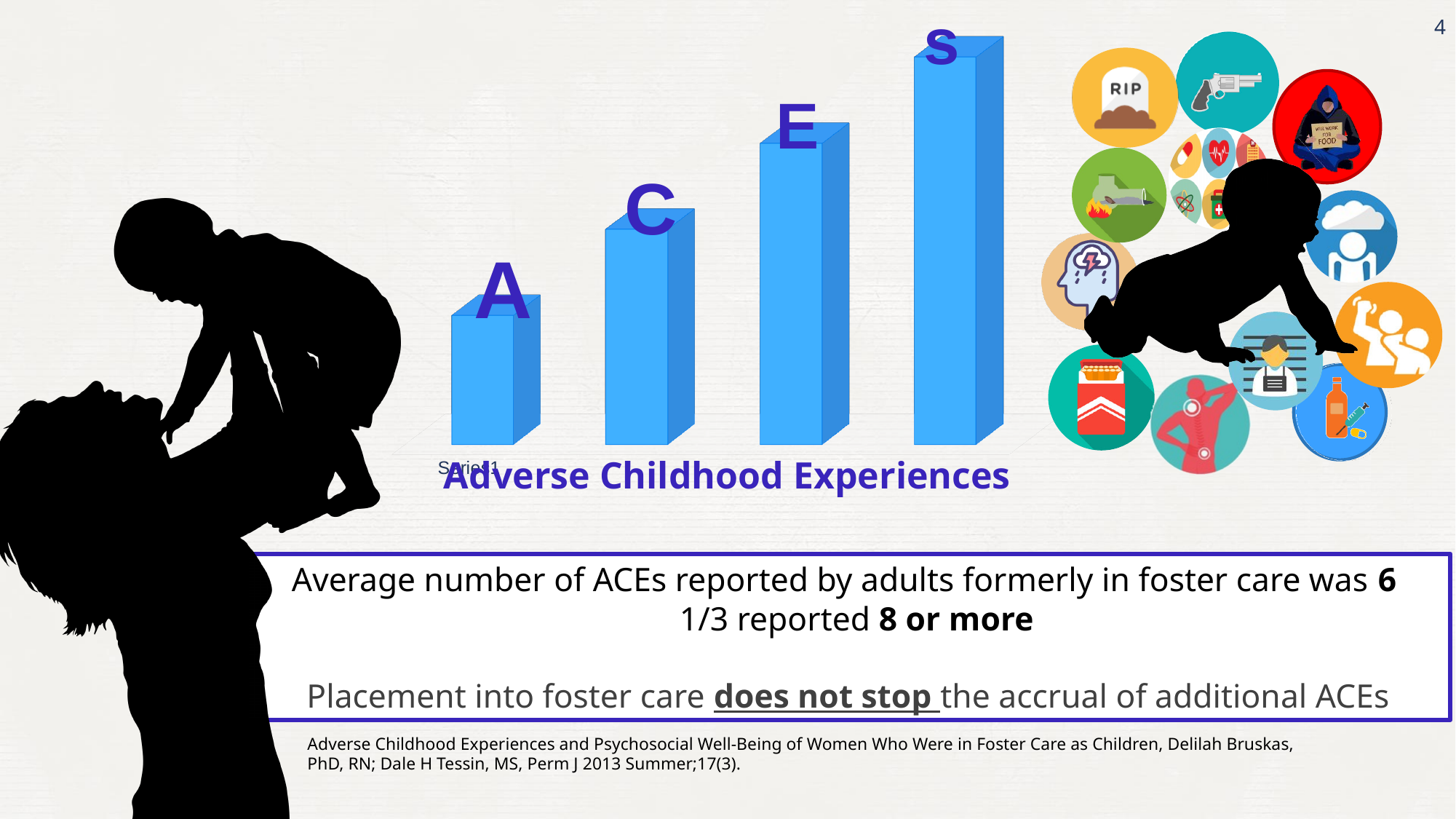
What is the title shown beneath the chart? Adverse Childhood Experiences Do the bars rise or fall from left to right across the chart? rise Which bar in the chart is the tallest? S What colour are the bars in the chart? blue How many bars does the chart contain? 4 What kind of chart is shown on the slide? bar chart Which bar in the chart is the shortest? A Which bar is taller, the one labelled C or the one labelled E? E What letters are printed above the four bars, from left to right? A, C, E, S Which bar is taller, the one labelled A or the one labelled C? C